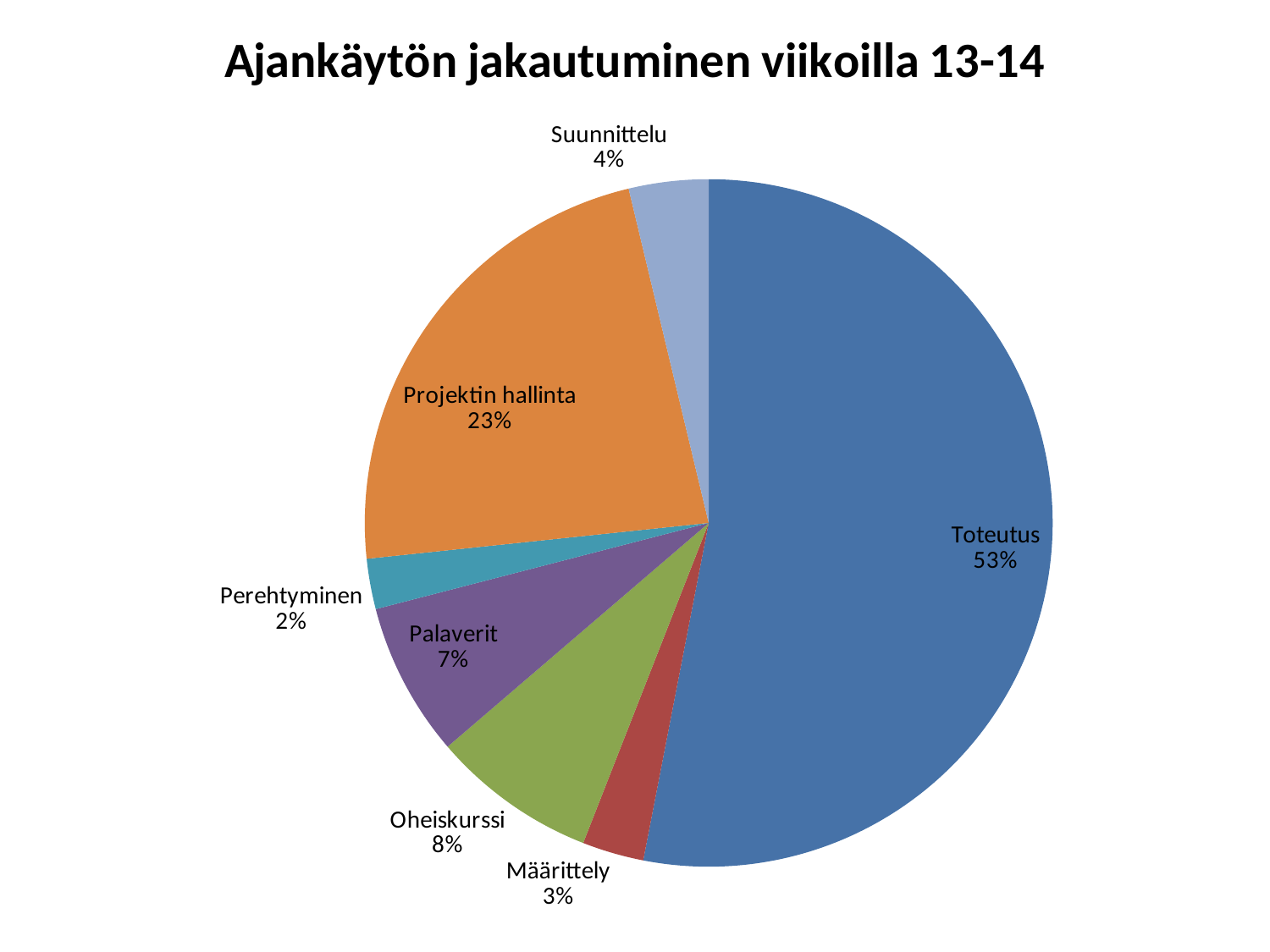
What is the value shown for Palaverit? 7% What is the difference between the shares of Toteutus and Projektin hallinta? 30% What is the value shown for Oheiskurssi? 8% What is the title of the chart? Ajankäytön jakautuminen viikoilla 13-14 What is the value shown for Suunnittelu? 4% What share of the pie does Toteutus take? 53% What share of the pie does Projektin hallinta take? 23% Which category has the largest slice? Toteutus What kind of chart is shown on the slide? Pie chart How many categories are shown in the pie chart? 7 Which is larger, Oheiskurssi or Palaverit? Oheiskurssi Which category has the smallest slice? Perehtyminen